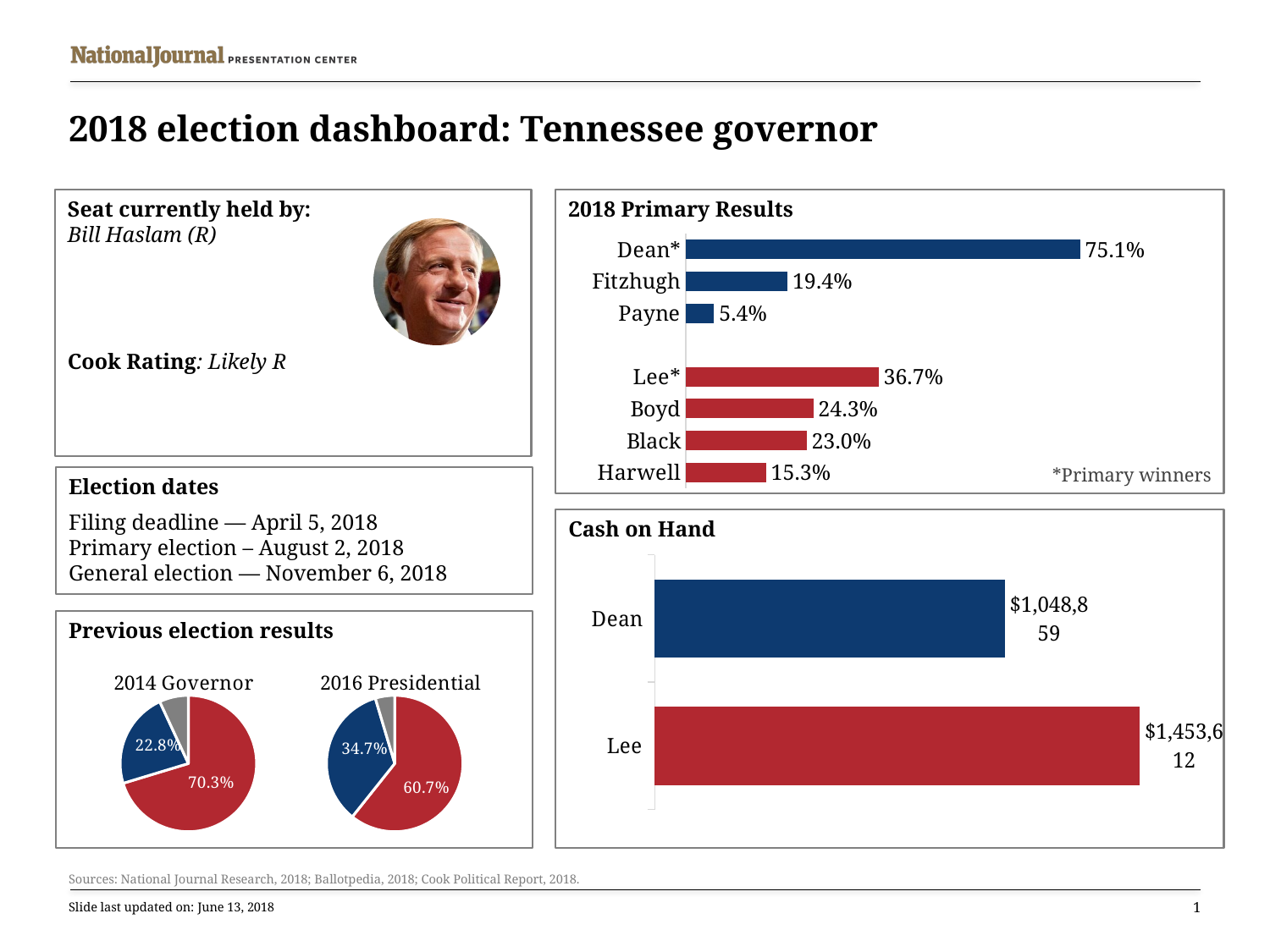
How many candidates are shown in the 2018 Primary Results chart? 7 In the 2018 Primary Results chart, what percentage did Dean* receive? 75.1% In the 2018 Primary Results chart, what is the difference in percentage points between Lee* and Boyd? 12.4 percentage points In the 2018 Primary Results chart, what percentage did Harwell receive? 15.3% In the 2016 Presidential pie chart under Previous election results, what share does the blue slice represent? 34.7% In the 2014 Governor pie chart under Previous election results, what share does the largest slice represent? 70.3% In the 2018 Primary Results chart, which candidate has the highest percentage? Dean* In the Cash on Hand chart, what is the difference between Lee's and Dean's cash on hand? $404,753 In the Cash on Hand chart, what is the value for Lee? $1,453,612 In the 2018 Primary Results chart, who received a higher percentage, Boyd or Black? Boyd In the 2018 Primary Results chart, which candidate has the lowest percentage? Payne What kind of chart is the 2018 Primary Results chart? Bar chart